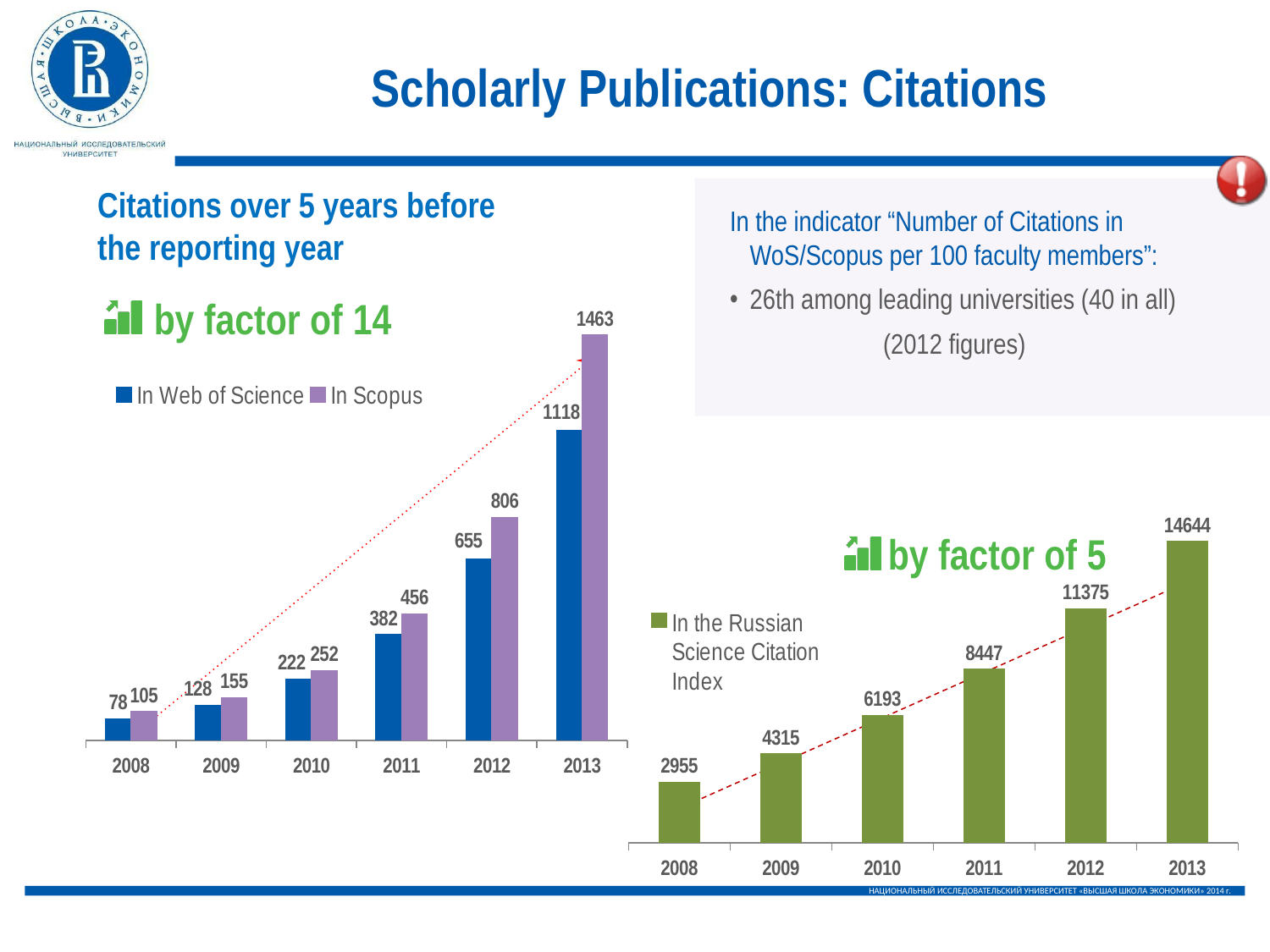
In the left chart (Web of Science / Scopus), what is the value for In Scopus in 2013? 1463 In the left chart (Web of Science / Scopus), how many series does the legend list? 2 In the right chart (Russian Science Citation Index), what is the value for 2011? 8447 In the left chart (Web of Science / Scopus), which year has the lowest In Web of Science value? 2008 In the left chart (Web of Science / Scopus), what is the difference between the In Scopus and In Web of Science values in 2012? 151 What kind of chart is the right chart (Russian Science Citation Index)? bar chart In the right chart (Russian Science Citation Index), what is the difference between the 2013 and 2008 values? 11689 In the left chart (Web of Science / Scopus), what is the value for In Web of Science in 2011? 382 In the right chart (Russian Science Citation Index), do the values rise or fall from 2008 to 2013? rise In the left chart (Web of Science / Scopus), how many years are shown on the x axis? 6 In the left chart (Web of Science / Scopus), which is larger in 2010: In Web of Science or In Scopus? In Scopus In the right chart (Russian Science Citation Index), which year has the highest value? 2013